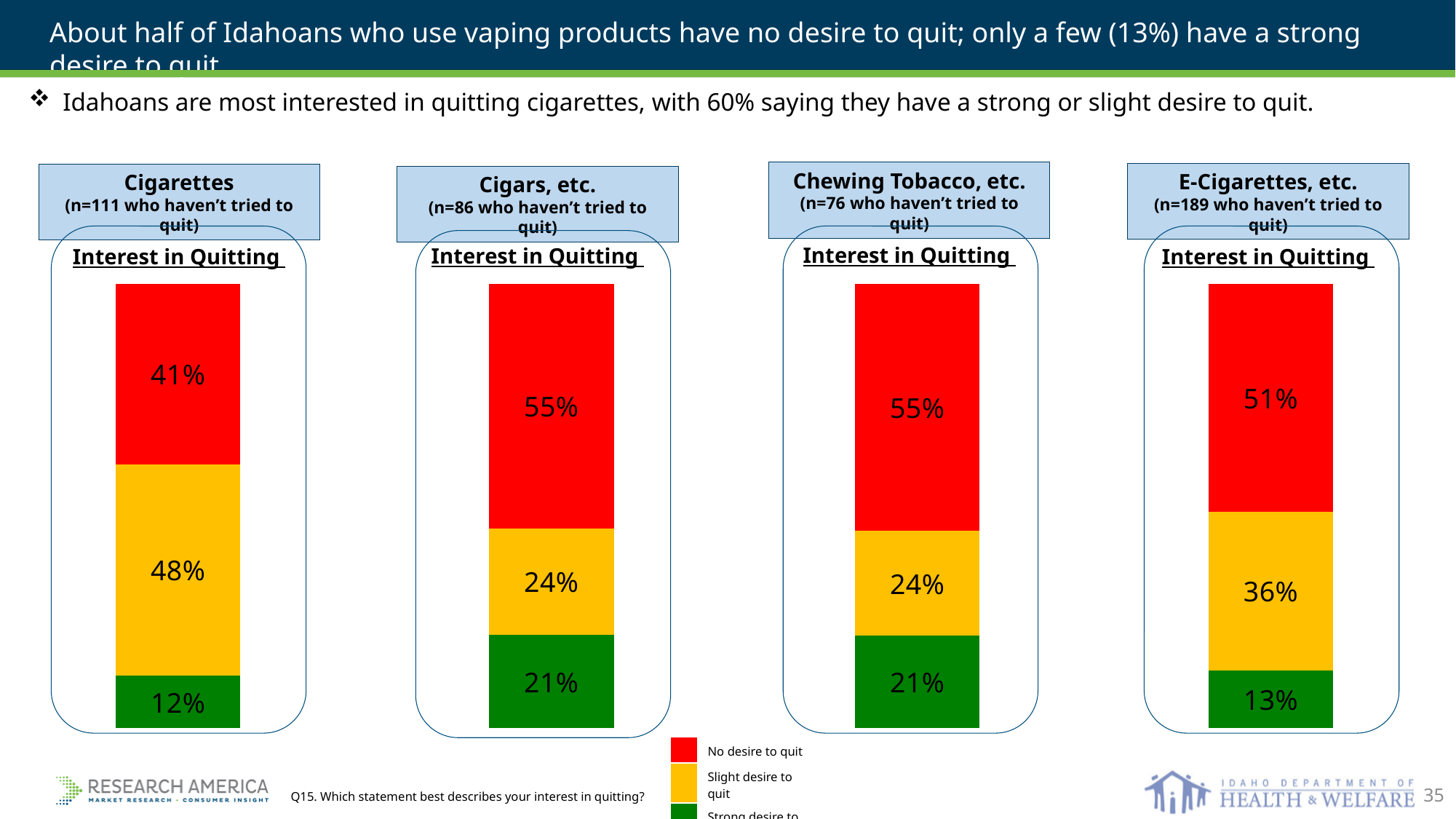
In the Chewing Tobacco, etc. chart, what percentage have a slight desire to quit? 24% Across the four charts, which product has the lowest percentage with no desire to quit? Cigarettes What type of chart is used to show interest in quitting for each product? Stacked bar chart How many segments does each stacked bar contain? 3 Which colour represents 'No desire to quit' in the legend? Red In the Cigarettes chart, what percentage have a slight desire to quit? 48% In the Cigarettes chart, which segment is larger: no desire to quit or slight desire to quit? Slight desire to quit In the E-Cigarettes, etc. chart, what is the difference between the no desire to quit share and the slight desire to quit share? 15% In the Cigars, etc. chart, what is the combined percentage of slight and strong desire to quit? 45% In the Cigarettes chart, what percentage have no desire to quit? 41% In the Cigars, etc. chart, what percentage have no desire to quit? 55% In the E-Cigarettes, etc. chart, what percentage is shown for the green (strong desire) segment? 13%